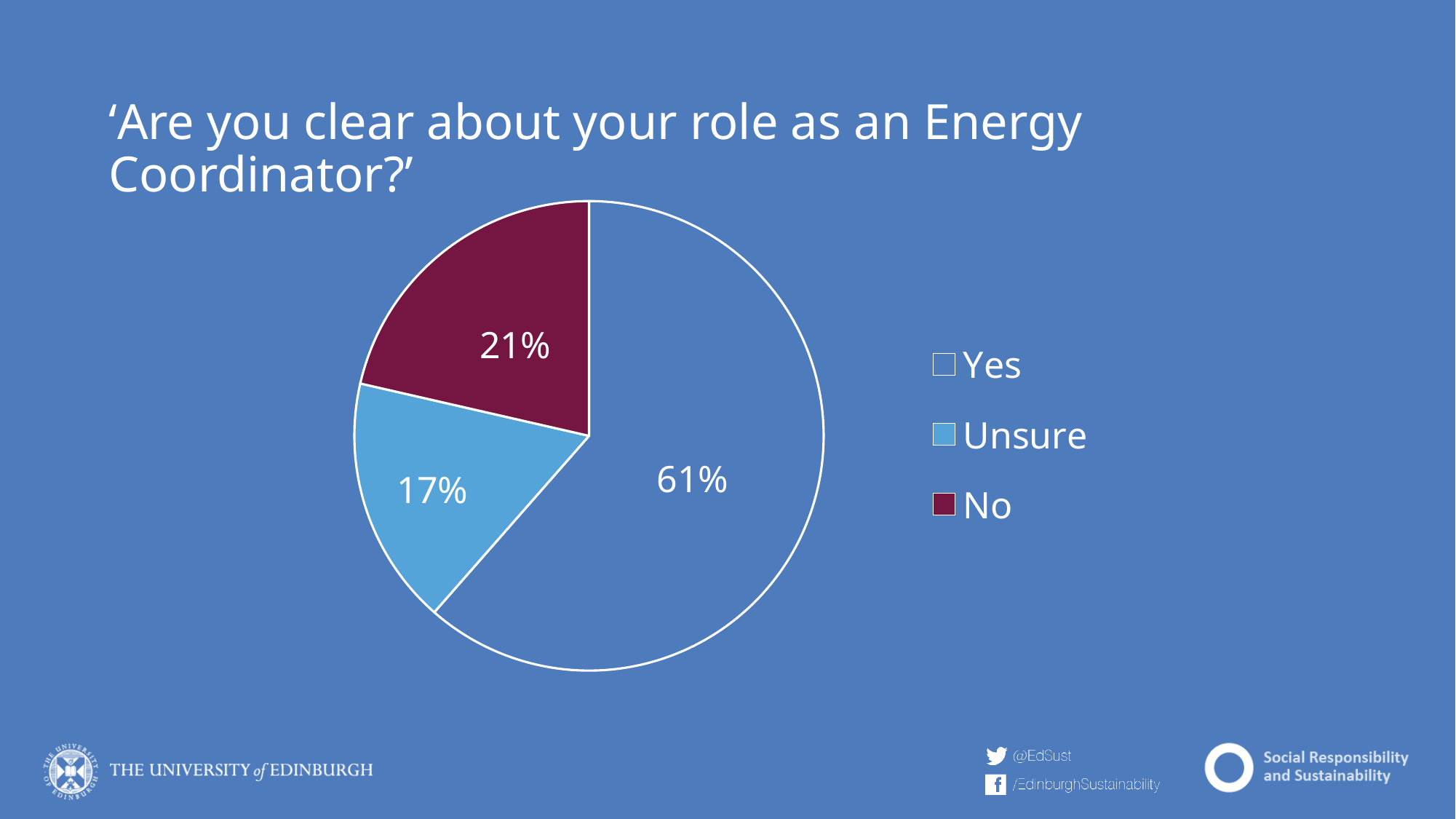
Which response has the largest share of the pie? Yes What is the difference in percentage points between the Yes and No slices? 40 How many slices does the pie chart have? 3 What is the difference in percentage points between the No and Unsure slices? 4 How many entries does the legend list? 3 Which response has the smallest share of the pie? Unsure What percentage of respondents answered Yes? 61% What percentage of respondents answered Unsure? 17% Which slice is larger, No or Unsure? No What colour is the No slice in the pie chart? Dark red What kind of chart is shown on the slide? Pie chart What percentage of respondents answered No? 21%